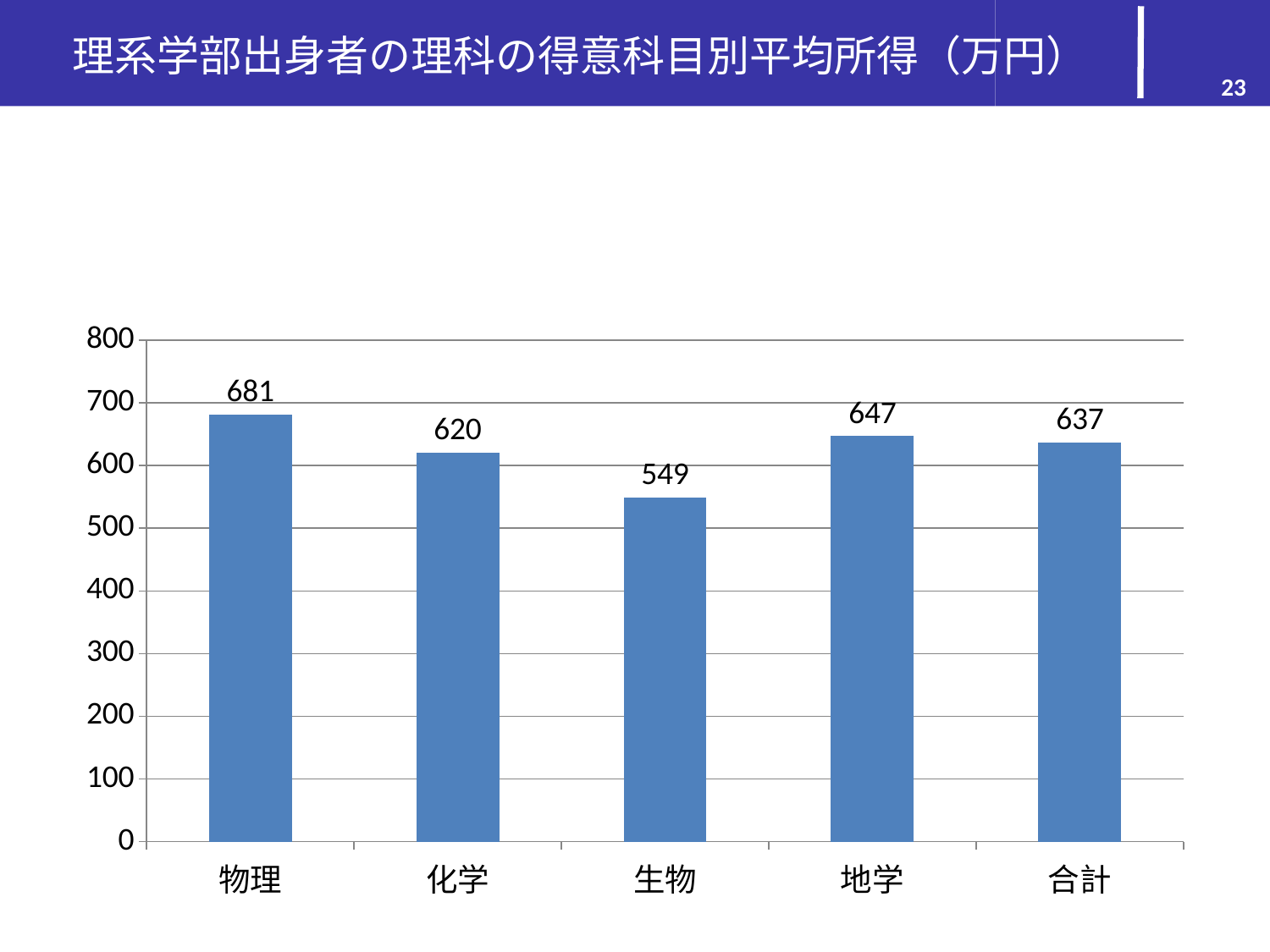
What is the value for 物理? 681 How many categories are shown on the x axis? 5 What is the difference between the values for 物理 and 生物? 132 What kind of chart is shown on the slide? bar chart Is the value for 化学 greater or less than 600? greater What is the value for 合計? 637 Which is larger, the value for 地学 or the value for 合計? 地学 Which category has the highest value? 物理 What is the title of the slide? 理系学部出身者の理科の得意科目別平均所得（万円） What is the difference between the values for 地学 and 化学? 27 What is the value for 生物? 549 Which category has the lowest value? 生物